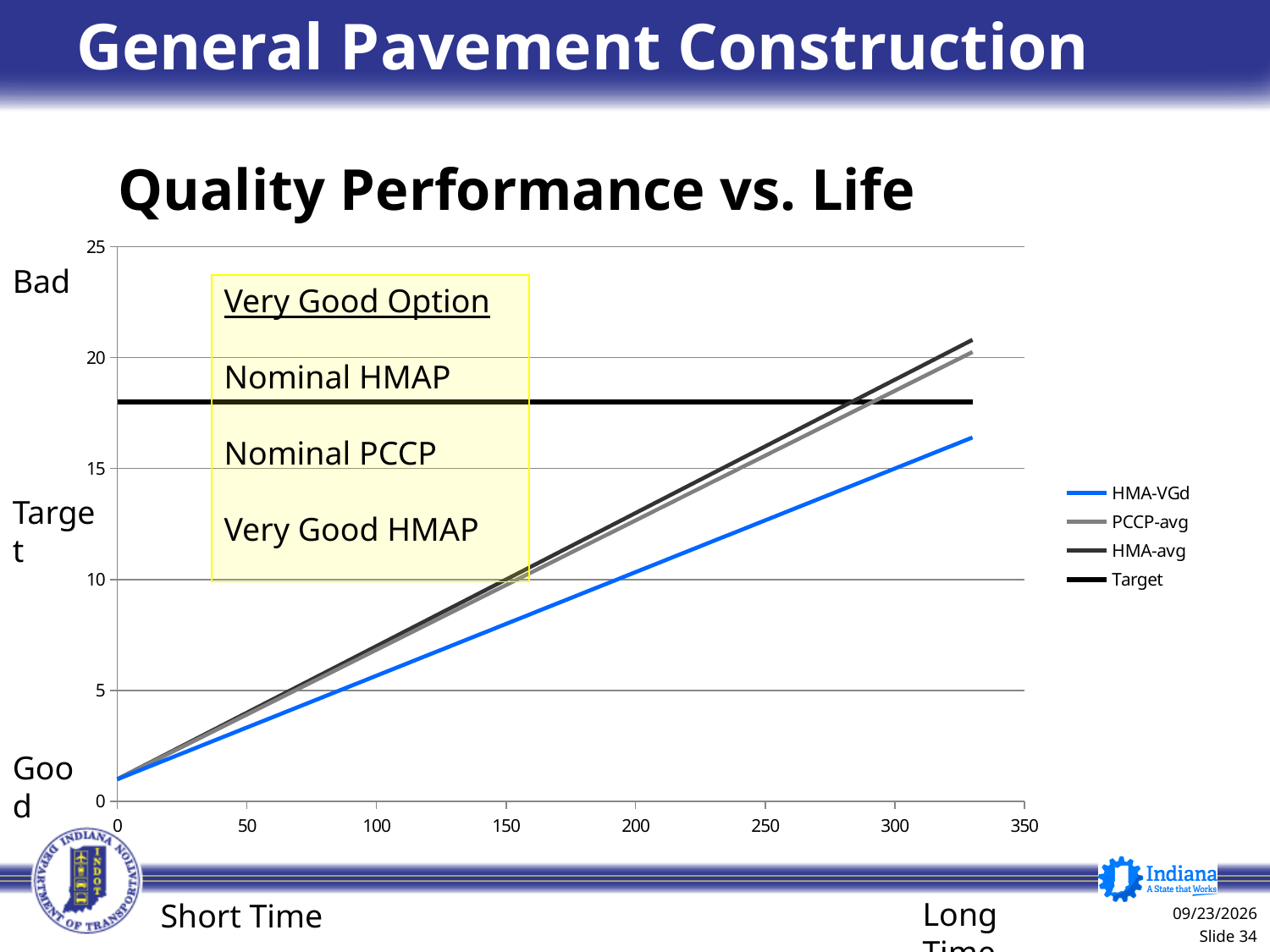
Is the value of HMA-avg at x = 200 greater or less than 10? greater Is the value of HMA-VGd at x = 250 greater or less than 15? less Is the value of the Target line greater or less than 20? less Does the Target line rise, fall, or stay flat across the x axis? stay flat Which of the three rising series has the lowest value at x = 300? HMA-VGd What is the title of the chart? Quality Performance vs. Life Does the HMA-VGd line rise or fall as the x axis increases? rise What kind of chart is shown on the slide? line chart At x = 300, which is larger, HMA-avg or HMA-VGd? HMA-avg How many series does the chart legend list? 4 Which series is drawn in blue? HMA-VGd